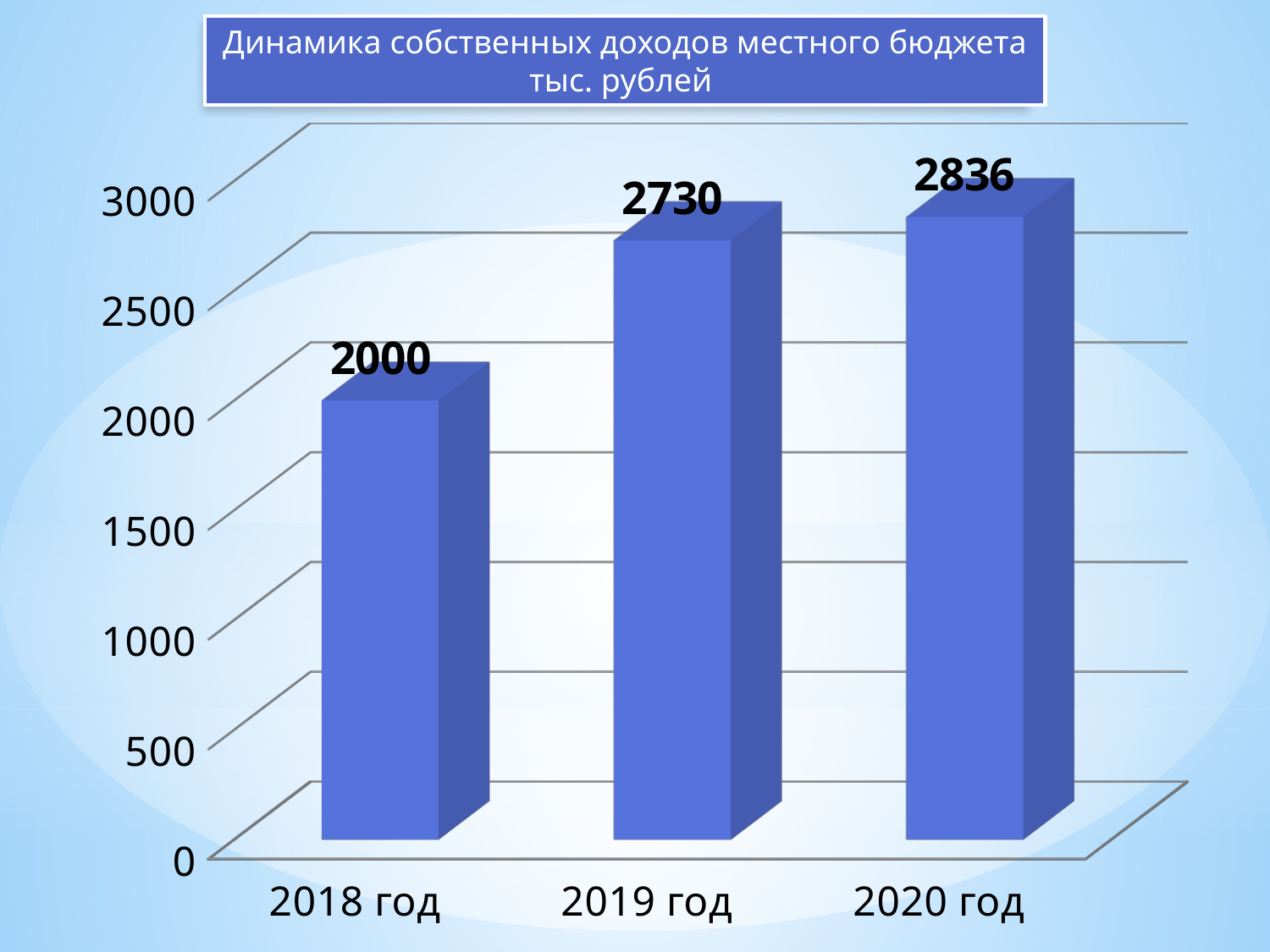
Which year has the highest value? 2020 год Do the values rise or fall from 2018 год to 2020 год? rise What is the value for 2019 год? 2730 How many years are shown on the chart? 3 Is the value for 2018 год greater or less than 2500? less Which is larger, the value for 2018 год or the value for 2019 год? 2019 год What is the value for 2018 год? 2000 Which year has the lowest value? 2018 год What is the difference between the values for 2019 год and 2018 год? 730 What kind of chart is shown on the slide? bar chart What is the difference between the values for 2020 год and 2019 год? 106 What is the value for 2020 год? 2836